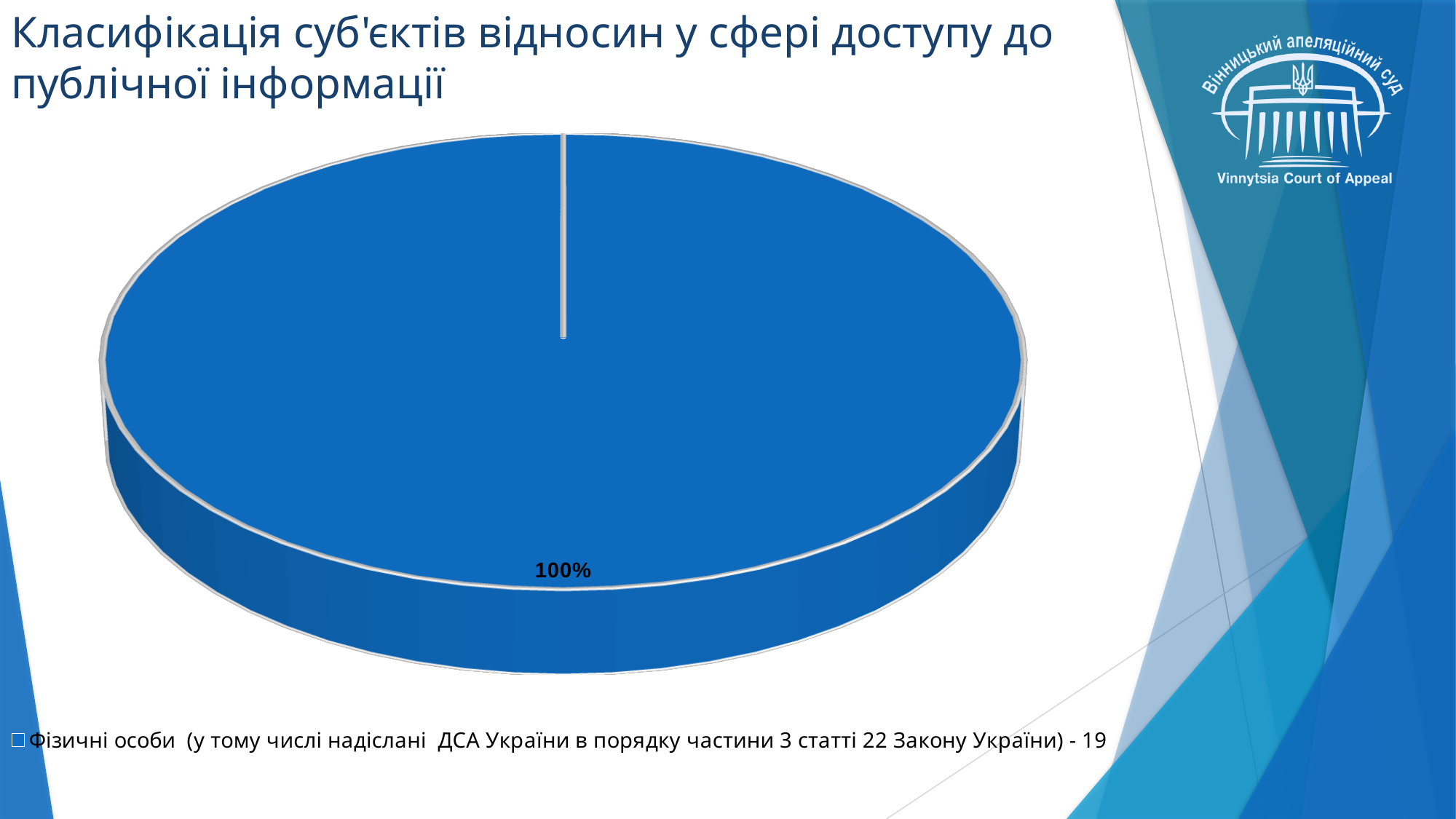
What kind of chart is shown on the slide? pie chart What is the title of the chart on the slide? Класифікація суб'єктів відносин у сфері доступу до публічної інформації What number is given at the end of the legend entry for "Фізичні особи"? 19 What share of the pie does the slice labelled "Фізичні особи (у тому числі надіслані ДСА України в порядку частини 3 статті 22 Закону України) - 19" represent? 100% What percentage label is printed on the pie chart? 100% How many entries does the legend list? 1 What colour is the single slice of the pie chart? blue How many slices does the pie chart have? 1